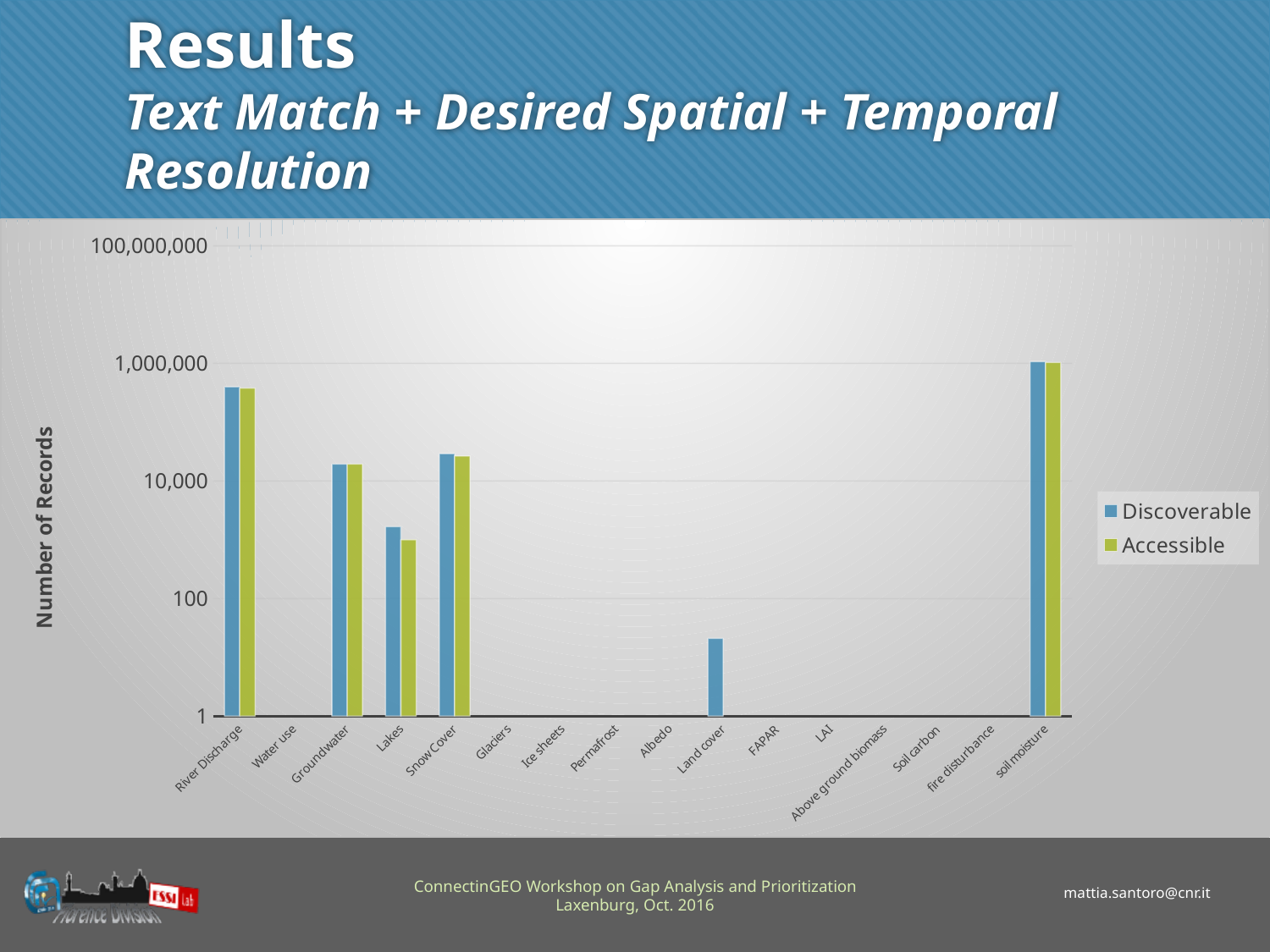
Is the Discoverable value for Land cover greater or less than 100? less What is the title of the y axis? Number of Records How many categories are shown on the x axis? 16 For Lakes, which series has the larger value, Discoverable or Accessible? Discoverable Is the Discoverable value for River Discharge greater or less than 10,000? greater Which has more Discoverable records, Snow Cover or Groundwater? Snow Cover Which category has the highest number of records? soil moisture What kind of chart is shown on the slide? bar chart Is the Accessible value for Snow Cover greater or less than 10,000? greater Which category with a visible bar has the lowest number of records? Land cover How many series does the legend list? 2